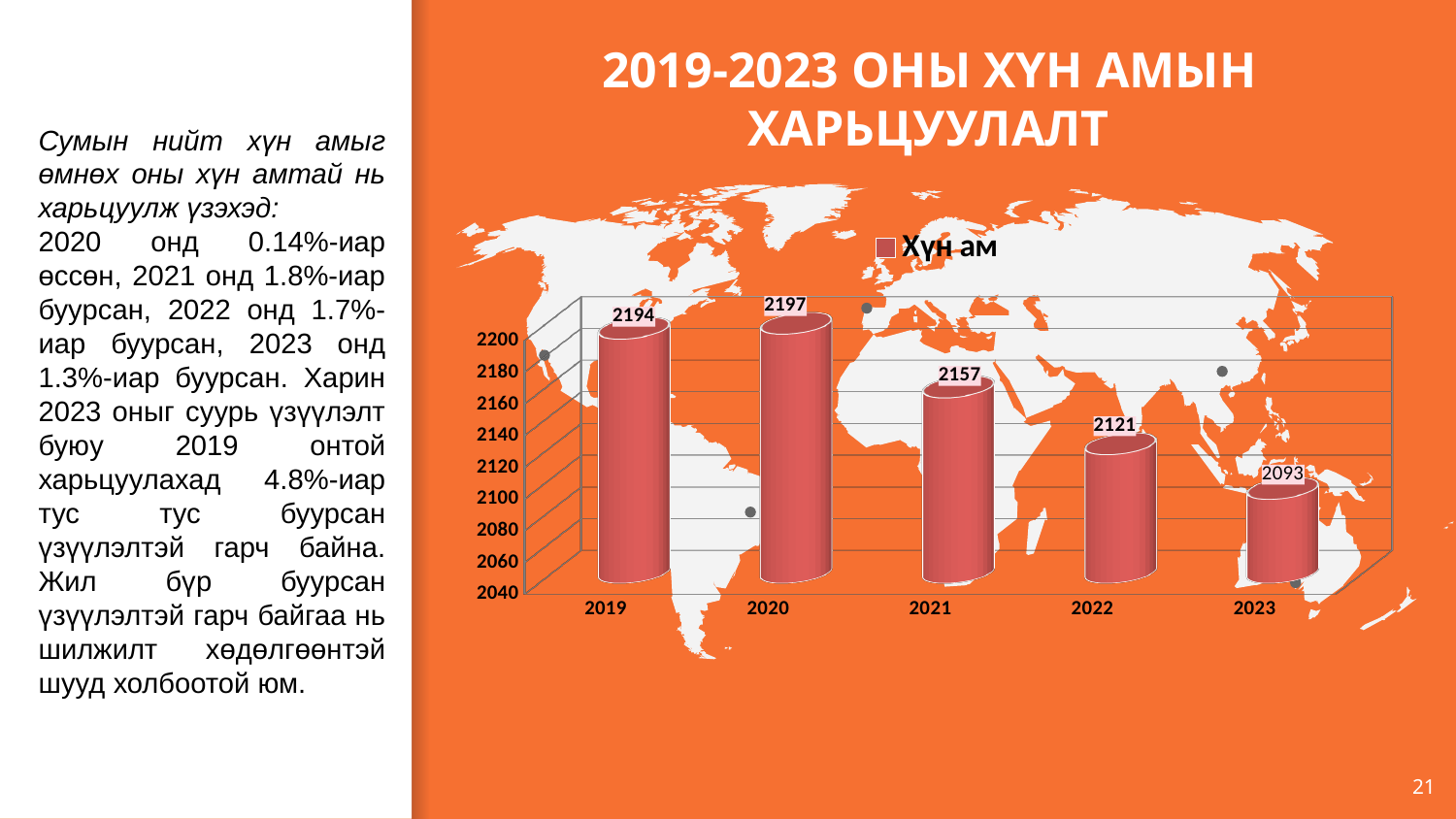
What is the difference between the population values for 2021 and 2022? 36 How many years are shown on the x axis of the chart? 5 Which year has the highest population value? 2020 Which year has the lowest population value? 2023 What is the difference between the population values for 2020 and 2023? 104 What is the population value shown for 2019? 2194 How many series does the chart legend list? 1 What is the population value shown for 2023? 2093 What kind of chart is shown on the slide? Bar chart Which is larger, the population value for 2021 or for 2022? 2021 What is the name of the series shown in the chart legend? Хүн ам What is the population value shown for 2021? 2157